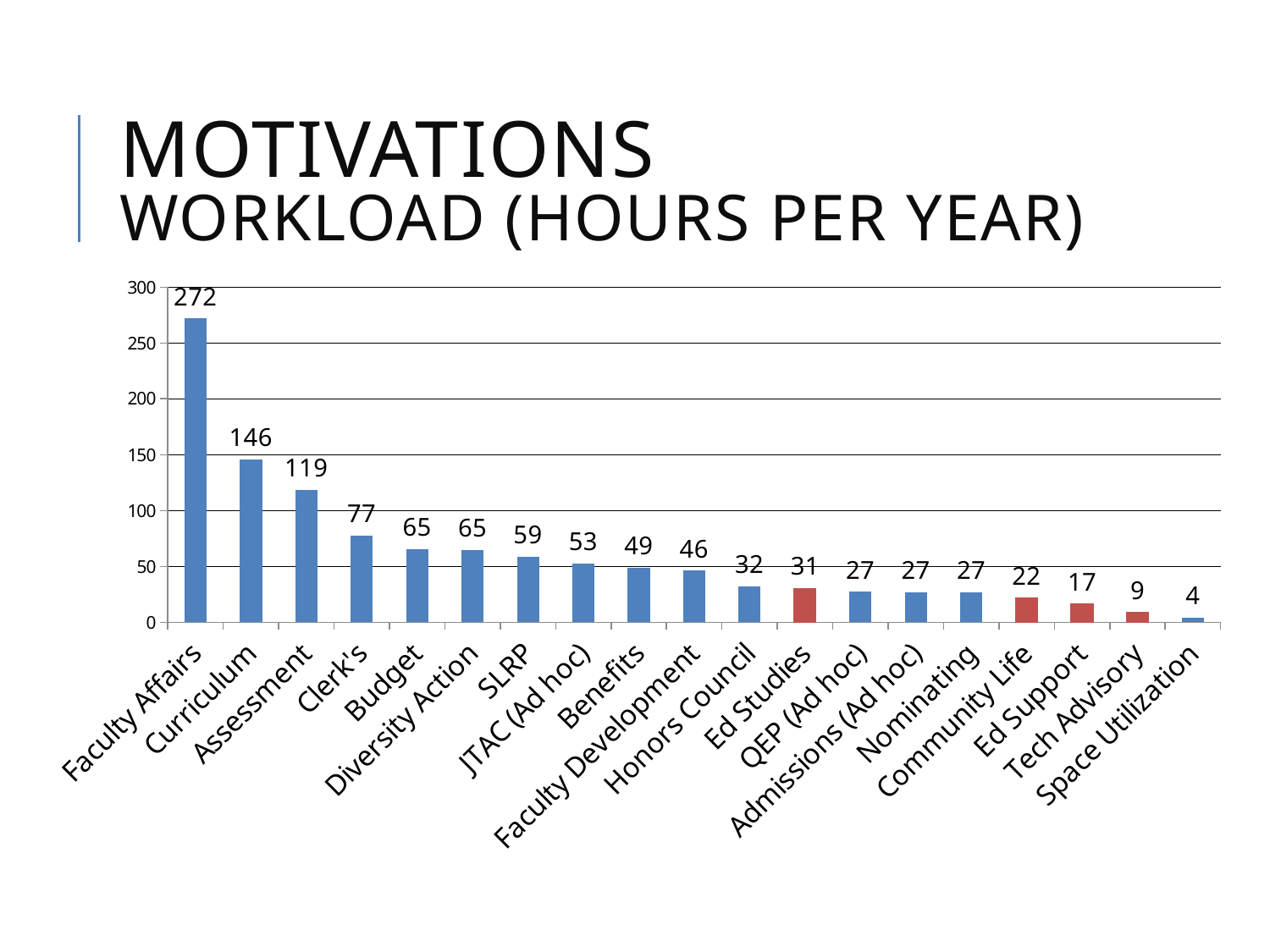
Which has a larger value, Benefits or Honors Council? Benefits Which category has the lowest workload? Space Utilization How many bars are coloured red rather than blue? 4 What is the value shown for Space Utilization? 4 Which category has the highest workload? Faculty Affairs What is the difference between the values for Assessment and Clerk's? 42 What is the value shown for JTAC (Ad hoc)? 53 What is the workload in hours per year for Faculty Affairs? 272 What is the value shown for Curriculum? 146 What is the difference between the values for Faculty Affairs and Curriculum? 126 How many categories are shown on the x axis? 19 What kind of chart is shown on the slide? Bar chart